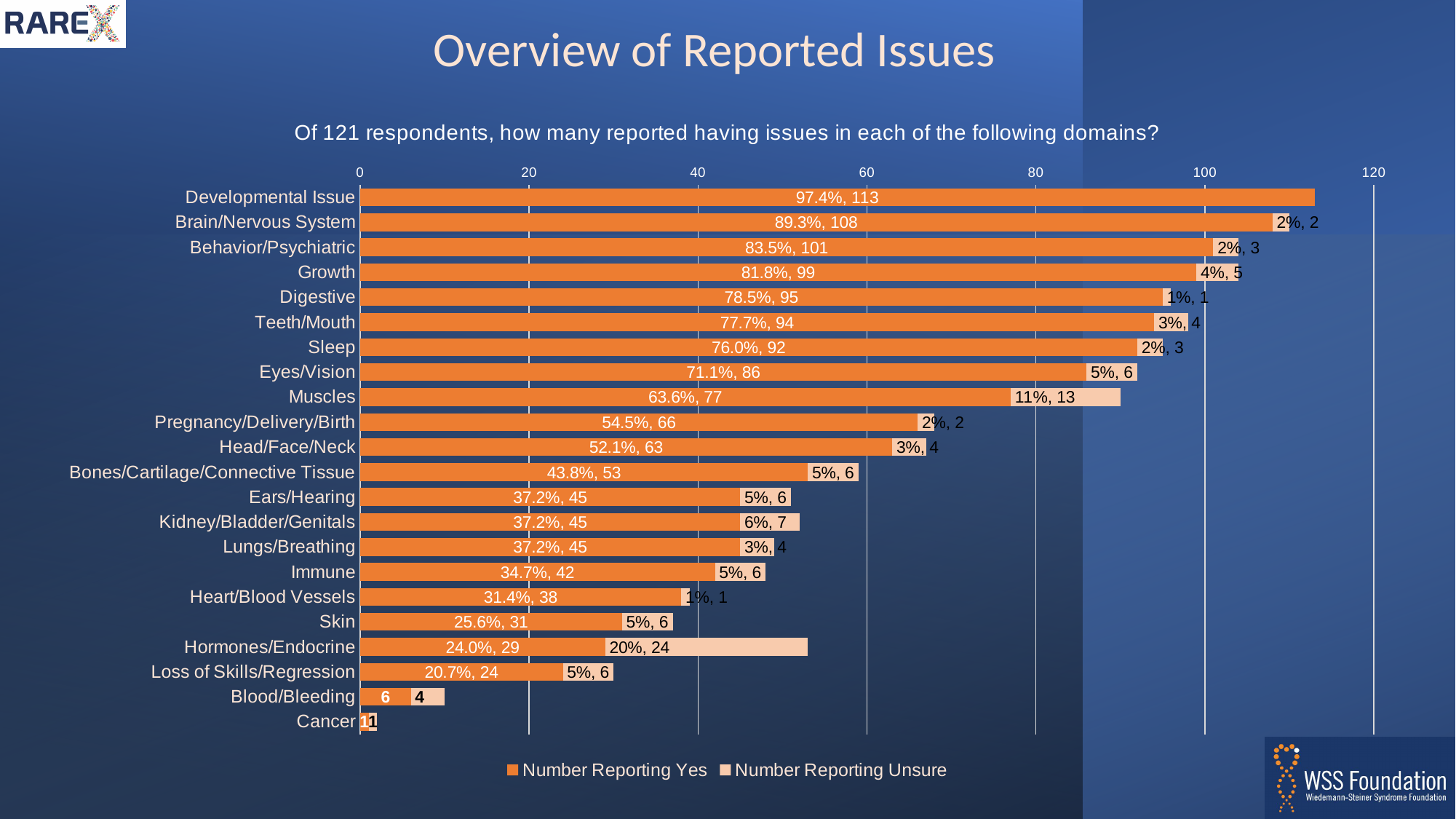
What is the total of the stacked bar for Muscles (Yes plus Unsure)? 90 Which has a larger Number Reporting Yes, Sleep or Eyes/Vision? Sleep Which domain has the highest Number Reporting Unsure? Hormones/Endocrine What kind of chart is shown on the slide? Stacked bar chart What percentage of respondents reported Yes for Skin issues? 25.6% How many domains are listed on the chart? 22 Which domain has the lowest Number Reporting Yes? Cancer What is the Number Reporting Unsure for Hormones/Endocrine? 24 How many series does the legend list? 2 Which domain has the highest Number Reporting Yes? Developmental Issue What is the Number Reporting Yes for Muscles? 77 What is the difference between the Number Reporting Yes for Growth and for Digestive? 4